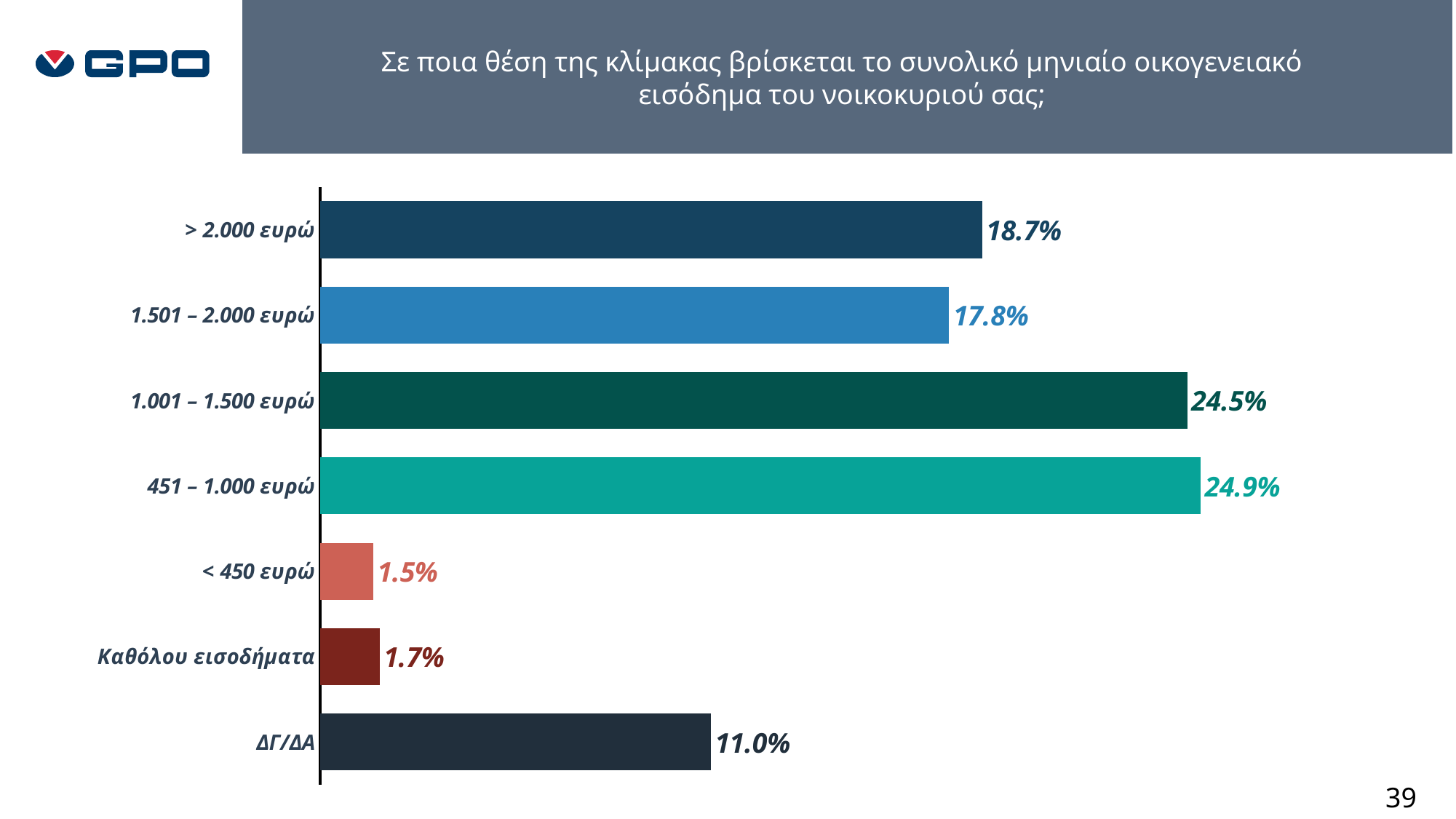
What is the value shown for the category 1.501 – 2.000 ευρώ? 17.8% What is the value shown for the category 451 – 1.000 ευρώ? 24.9% Which category has the lowest percentage? < 450 ευρώ What is the difference in percentage points between ΔΓ/ΔΑ and Καθόλου εισοδήματα? 9.3 percentage points Which is larger: the value for 1.001 – 1.500 ευρώ or the value for 1.501 – 2.000 ευρώ? 1.001 – 1.500 ευρώ What percentage of respondents reported a monthly household income of more than 2.000 euros (> 2.000 ευρώ)? 18.7% What is the value shown for Καθόλου εισοδήματα? 1.7% What type of chart is shown on the slide? Bar chart What is the difference in percentage points between the 451 – 1.000 ευρώ category and the > 2.000 ευρώ category? 6.2 percentage points What percentage is shown for ΔΓ/ΔΑ (don't know / no answer)? 11.0% How many income categories are shown in the chart? 7 Which income category has the highest percentage? 451 – 1.000 ευρώ